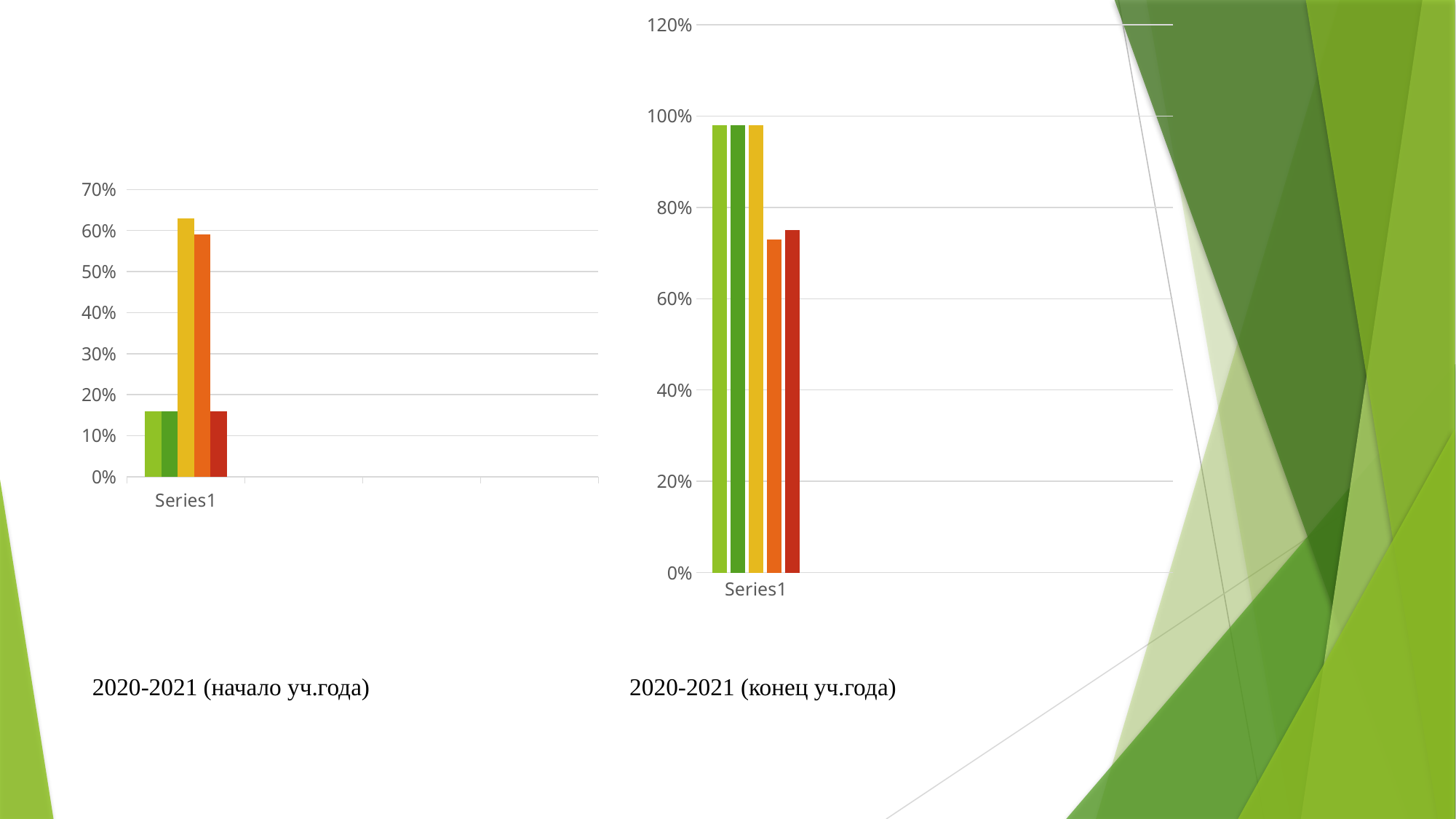
In the right chart (конец уч.года), how many bars are plotted? 5 In the left chart (начало уч.года), is the value of the yellow bar greater or less than 60%? greater In the left chart (начало уч.года), is the value of the light green bar greater or less than 20%? less In the left chart (начало уч.года), how many bars are plotted? 5 What is the category label shown on the x axis of the left chart (начало уч.года)? Series1 In the right chart (конец уч.года), is the value of the light green bar greater or less than 80%? greater What kind of chart is the left chart, captioned "2020-2021 (начало уч.года)"? bar chart What kind of chart is the right chart, captioned "2020-2021 (конец уч.года)"? bar chart In the left chart (начало уч.года), which coloured bar is the highest? the yellow bar In the right chart (конец уч.года), which is larger: the yellow bar or the dark red bar? the yellow bar